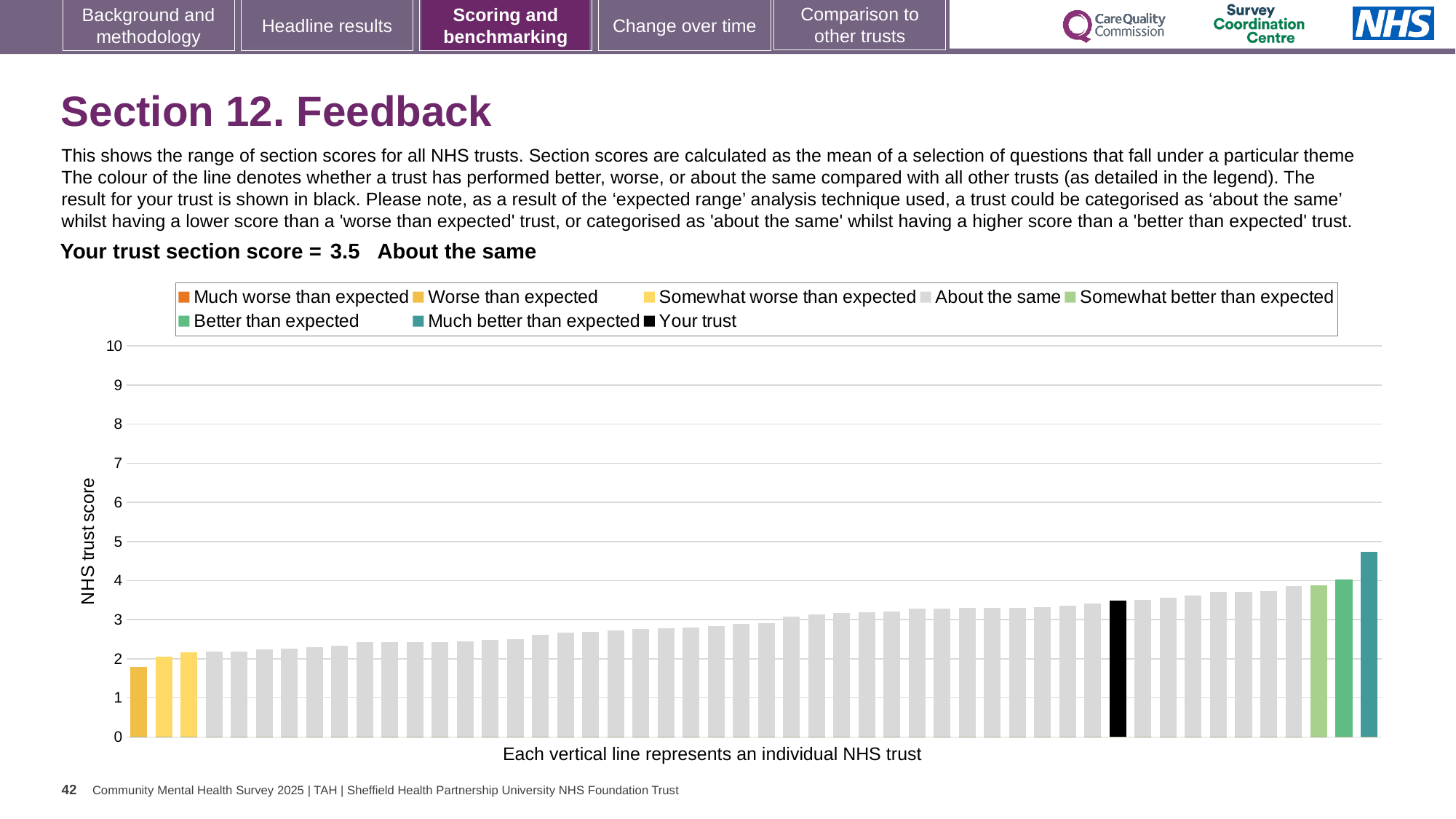
Is the value of the leftmost bar on the chart greater or less than 2? less Do the bar values rise or fall from left to right along the x axis? rise Which legend category does the tallest bar on the chart belong to? Much better than expected Which performance category is your trust placed in for this section? About the same What is the section score for your trust shown on the slide? 3.5 Is the value of the black 'Your trust' bar greater or less than 3? greater Which is larger: the rightmost bar or the black 'Your trust' bar? the rightmost bar Is the value of the tallest bar on the chart greater or less than 4? greater How many entries does the chart legend list? 8 What colour is used for the 'Your trust' bar in the chart? black What is the label on the vertical axis of the chart? NHS trust score What kind of chart is shown on the slide? bar chart